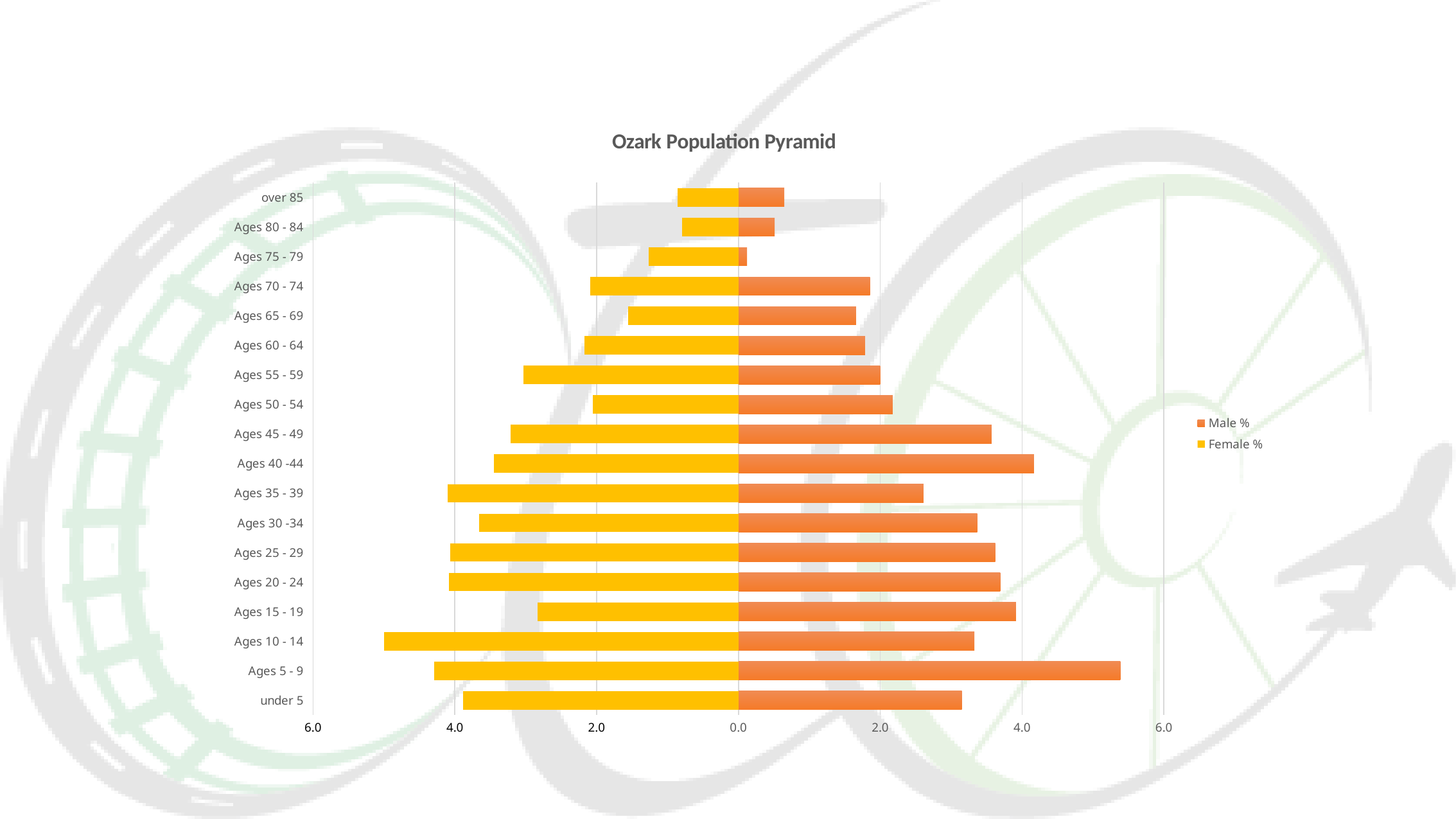
What is the title of the chart? Ozark Population Pyramid What kind of chart is shown on the slide? bar chart Which colour represents the Female % series in the legend? yellow How many series does the legend list? 2 Which age group has the lowest Male % value? Ages 75 - 79 Is the Male % value for Ages 5 - 9 greater or less than 4.0? greater Is the Female % value for Ages 10 - 14 greater or less than 4.0? greater How many age categories are plotted on the chart? 18 Which is larger, the Male % value for Ages 5 - 9 or for under 5? Ages 5 - 9 Which age group has the highest Female % value? Ages 10 - 14 Is the Female % value for Ages 15 - 19 greater or less than 4.0? less Which age group has the highest Male % value? Ages 5 - 9